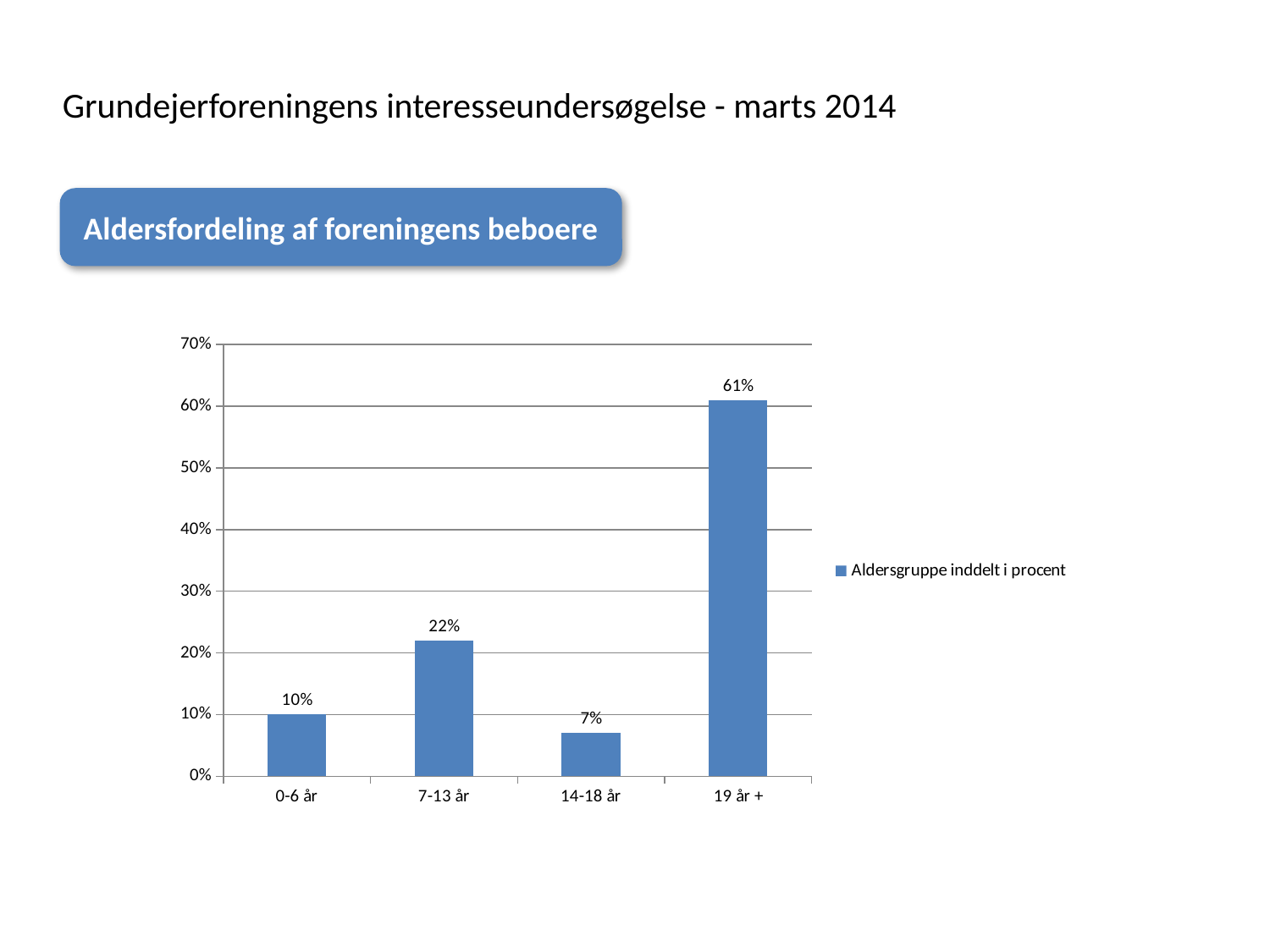
Which age group has the highest value? 19 år + What is the difference between the values for 19 år + and 7-13 år? 39% What is the value for the 7-13 år age group? 22% How many series does the legend list? 1 What kind of chart is shown on the slide? Bar chart Which age group has the lowest value? 14-18 år What is the value for the 0-6 år age group? 10% How many age groups are shown on the x axis? 4 What is the value for the 14-18 år age group? 7% What is the value for the 19 år + age group? 61% Which is larger, the value for 0-6 år or the value for 14-18 år? 0-6 år What is the legend entry for the series shown in the chart? Aldersgruppe inddelt i procent